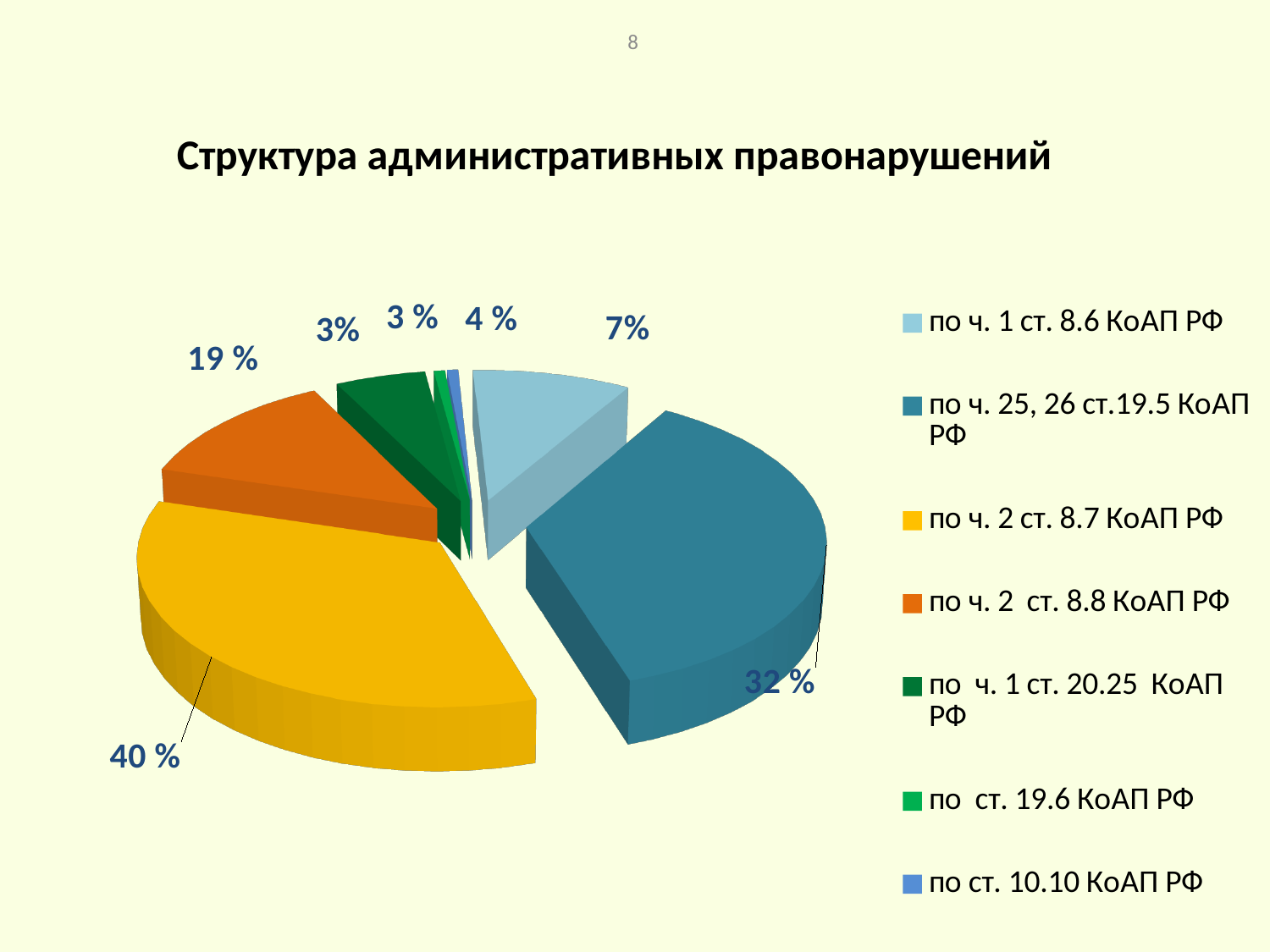
What share is shown for по ч. 2 ст. 8.7 КоАП РФ? 40 % What share is shown for по ч. 1 ст. 8.6 КоАП РФ? 7% By how many percentage points does the share of по ч. 2 ст. 8.7 КоАП РФ exceed that of по ч. 25, 26 ст.19.5 КоАП РФ? 8 % How many slices does the pie chart have? 7 Which has the larger share: по ч. 25, 26 ст.19.5 КоАП РФ or по ч. 2 ст. 8.8 КоАП РФ? по ч. 25, 26 ст.19.5 КоАП РФ What share is shown for по ч. 25, 26 ст.19.5 КоАП РФ? 32 % Which category has the largest share of the pie? по ч. 2 ст. 8.7 КоАП РФ What colour is the slice for по ч. 2 ст. 8.7 КоАП РФ? yellow Which has the larger share: по ч. 2 ст. 8.8 КоАП РФ or по ч. 1 ст. 8.6 КоАП РФ? по ч. 2 ст. 8.8 КоАП РФ What kind of chart is shown on the slide? pie chart What share is shown for по ч. 2 ст. 8.8 КоАП РФ? 19 % What is the title of the chart? Структура административных правонарушений